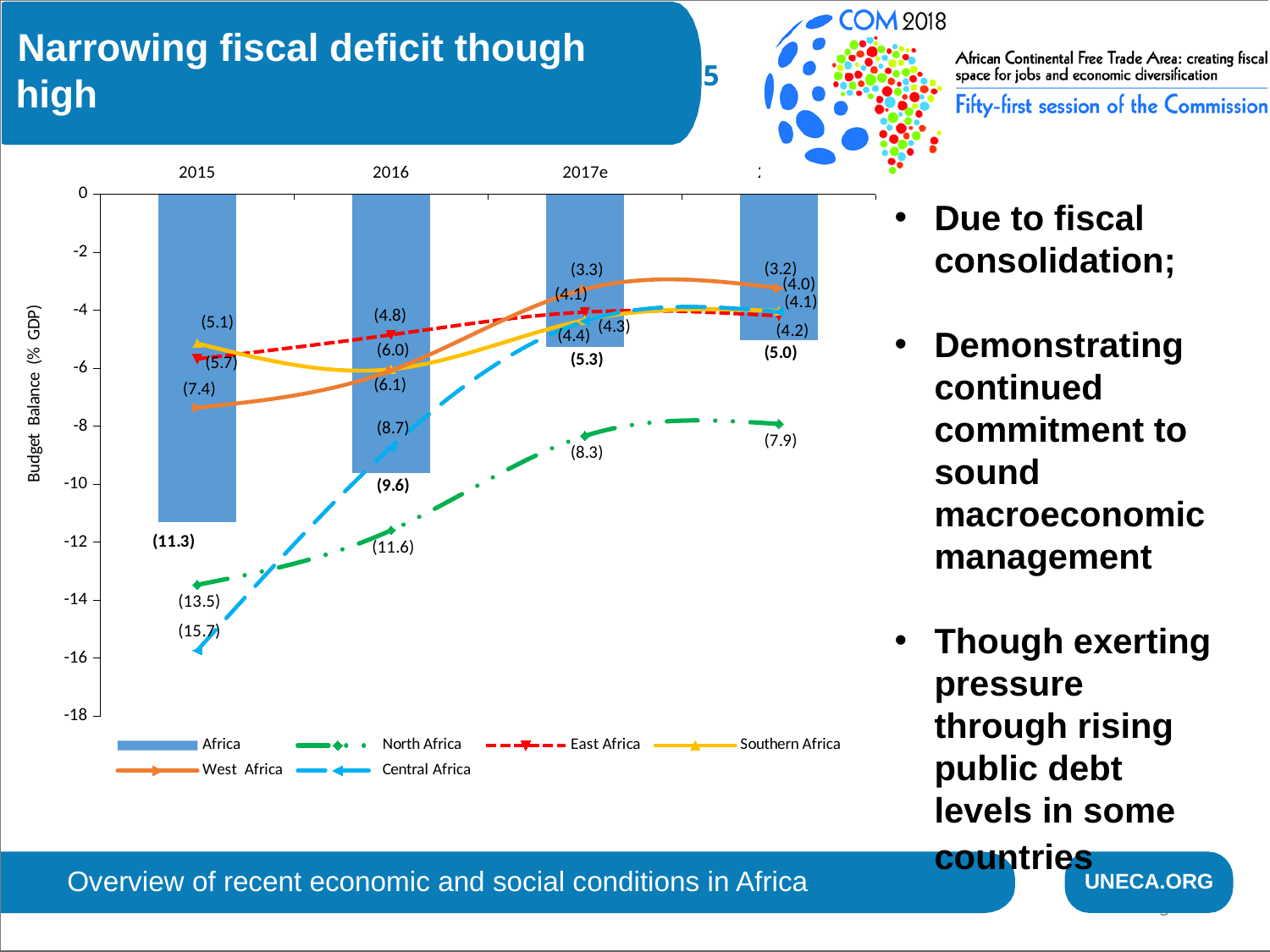
What is the data label on the Africa bar for 2015? (11.3) Which region had the largest budget deficit in 2015? Central Africa What is the East Africa value for 2016? (4.8) How many series does the chart legend list? 6 What is the data label on the Africa bar for 2016? (9.6) What is the North Africa value for 2015? (13.5) What is the Central Africa value for 2015? (15.7) What kind of chart is shown on the slide? A combined bar and line chart By how much did the Africa budget deficit narrow between 2015 (11.3) and 2016 (9.6)? 1.7 In 2016, which had the larger deficit: North Africa or Central Africa? North Africa What is the West Africa value for 2017e? (3.3) What is the data label on the Africa bar for 2017e? (5.3)